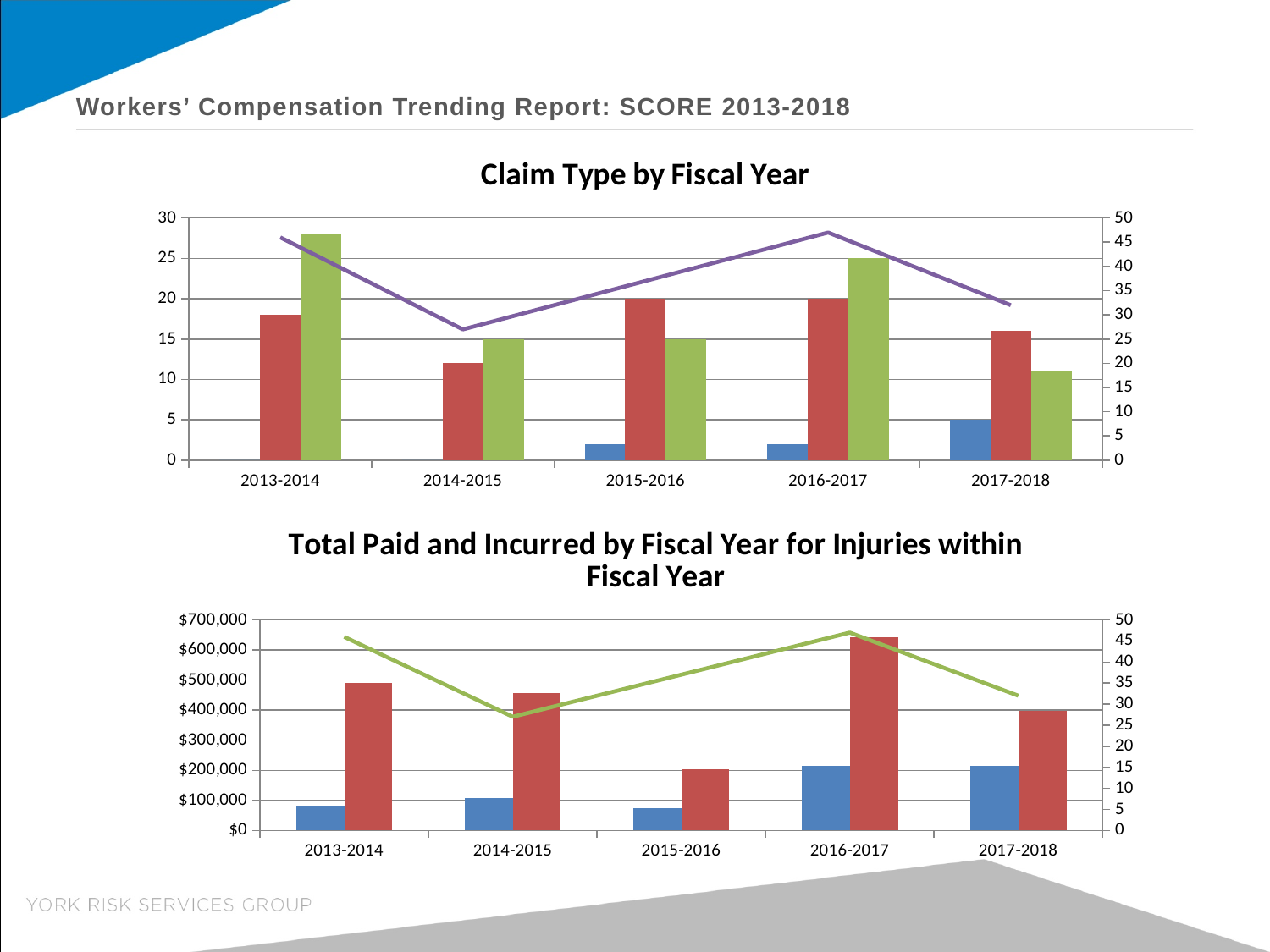
How many fiscal years are shown on the x axis of the top chart, Claim Type by Fiscal Year? 5 In the bottom chart, Total Paid and Incurred by Fiscal Year, is the red bar for 2016-2017 greater or less than $600,000? greater In the top chart, Claim Type by Fiscal Year, for 2017-2018 is the red bar or the green bar taller? red In the top chart, Claim Type by Fiscal Year, which fiscal year has the tallest green bar? 2013-2014 In the bottom chart, Total Paid and Incurred by Fiscal Year, is the red bar for 2015-2016 greater or less than $300,000? less In the top chart, Claim Type by Fiscal Year, in which fiscal year does the purple line reach its highest point? 2016-2017 What is the title of the top chart? Claim Type by Fiscal Year In the bottom chart, Total Paid and Incurred by Fiscal Year, which fiscal year has the tallest red bar? 2016-2017 How many fiscal years are shown on the x axis of the bottom chart, Total Paid and Incurred by Fiscal Year? 5 What kind of chart is the top chart, Claim Type by Fiscal Year? bar chart with a line In the top chart, Claim Type by Fiscal Year, is the green bar for 2013-2014 greater or less than 25? greater In the bottom chart, Total Paid and Incurred by Fiscal Year, in which fiscal year does the green line reach its lowest point? 2014-2015